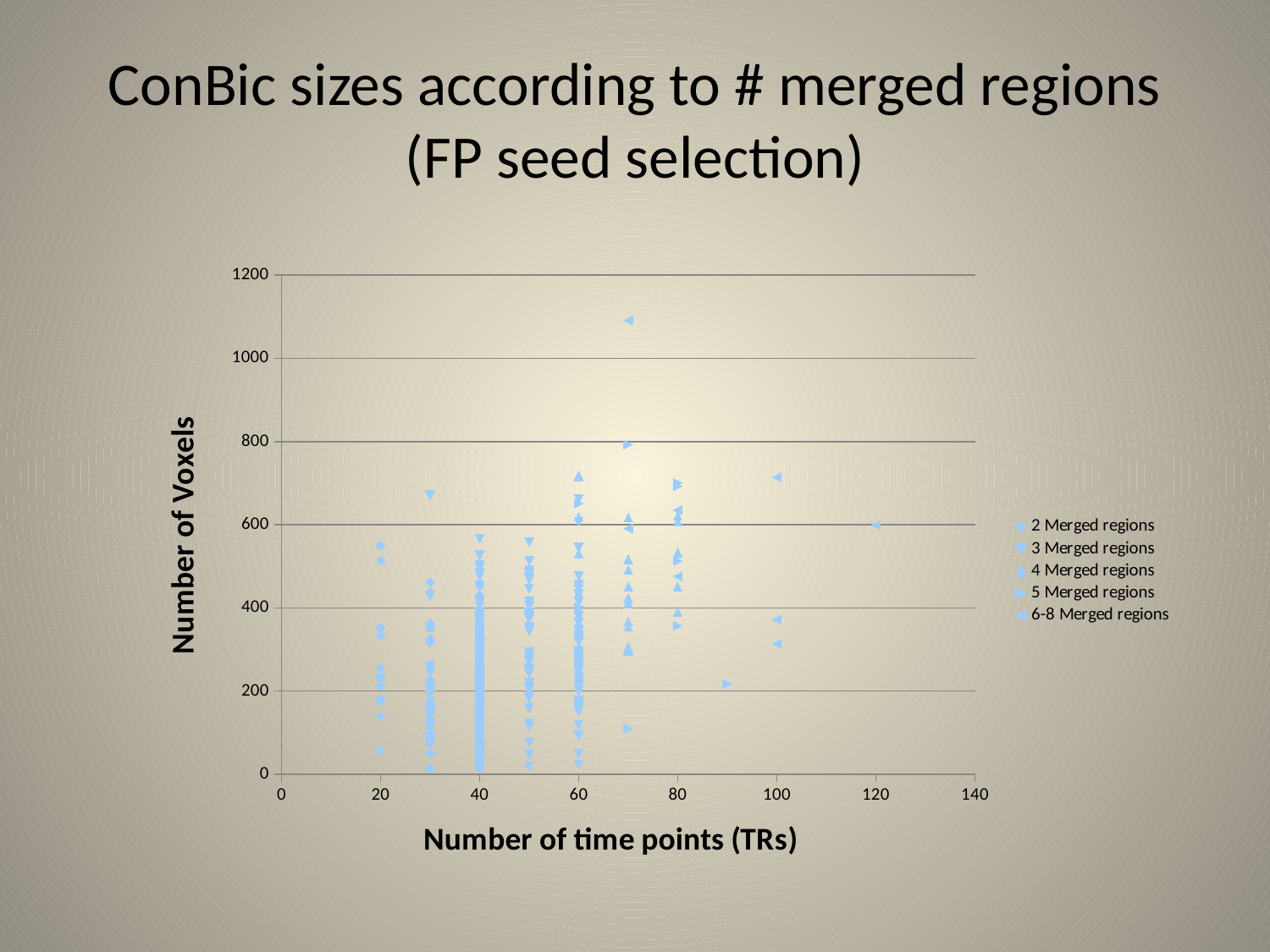
Is the highest point on the chart greater or less than 1000 voxels? greater Is the point at 90 time points greater or less than 400 voxels? less What kind of chart is shown on the slide? scatter chart What is the title of the chart? ConBic sizes according to # merged regions (FP seed selection) What is the maximum value shown on the x axis? 140 What is the label of the y axis? Number of Voxels How many series does the legend list? 5 Is the lowest point at 100 time points greater or less than 400 voxels? less